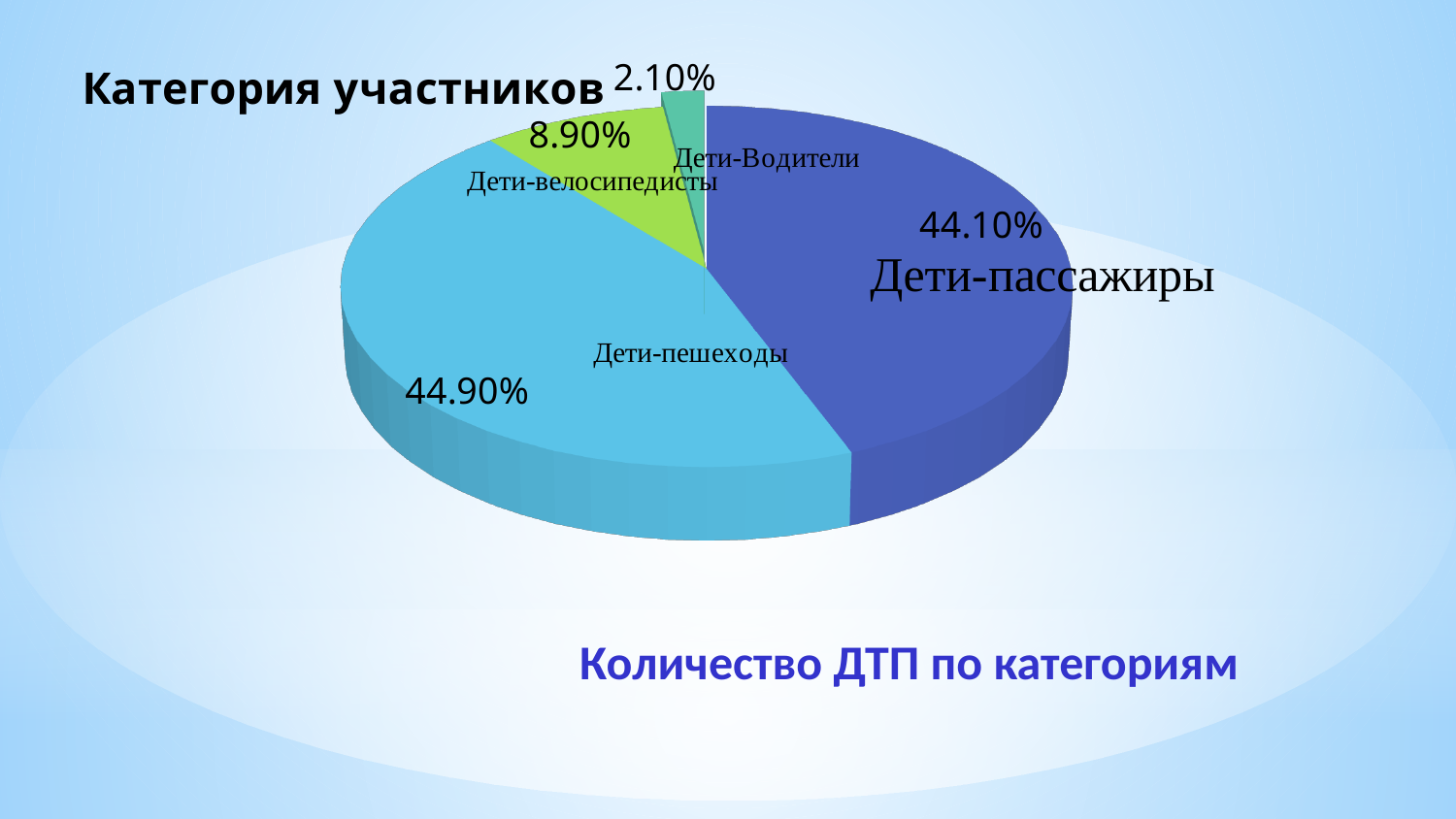
What is the difference in percentage points between Дети-велосипедисты and Дети-Водители? 6.80% Which category has the smallest share of the pie? Дети-Водители How many categories (slices) does the pie chart have? 4 What kind of chart is shown on the slide? Pie chart What share of the pie is labelled for Дети-пешеходы? 44.90% What is the title of the chart? Категория участников What is the difference in percentage points between Дети-пешеходы and Дети-пассажиры? 0.80% What share of the pie is labelled for Дети-Водители? 2.10% Which category has the largest share of the pie? Дети-пешеходы Which is larger: the share for Дети-велосипедисты or the share for Дети-Водители? Дети-велосипедисты What share of the pie is labelled for Дети-пассажиры? 44.10% What share of the pie is labelled for Дети-велосипедисты? 8.90%